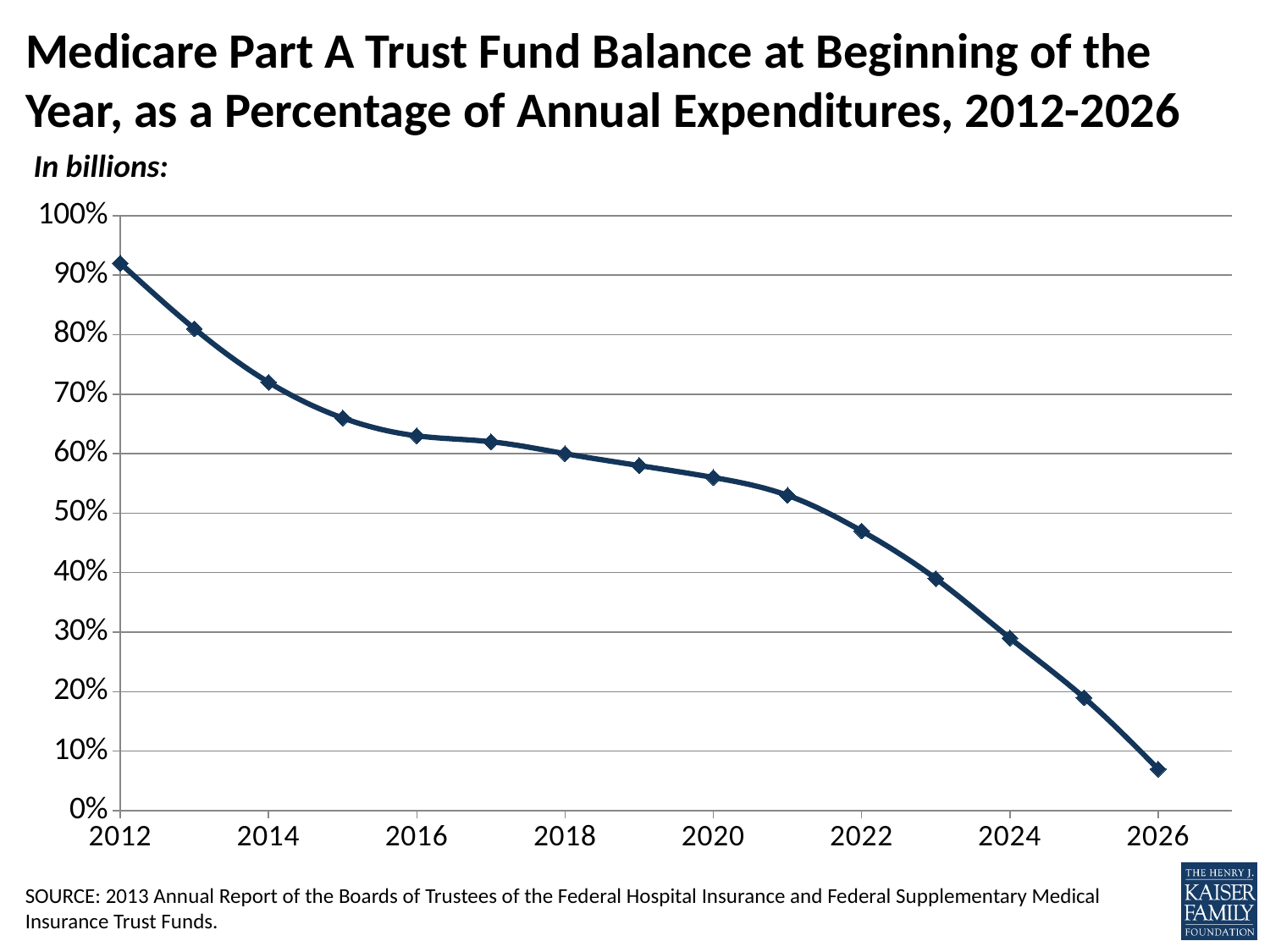
Which is larger, the value for 2016 or the value for 2024? 2016 Is the value for 2026 greater or less than 10%? less What is the source cited for the chart? 2013 Annual Report of the Boards of Trustees of the Federal Hospital Insurance and Federal Supplementary Medical Insurance Trust Funds Which year has the highest trust fund balance as a percentage of annual expenditures? 2012 Is the value for 2014 greater or less than 70%? greater Do the values rise or fall from 2012 to 2026? fall Which year has the lowest trust fund balance as a percentage of annual expenditures? 2026 How many data points are plotted on the line? 15 Is the value for 2012 greater or less than 90%? greater What kind of chart is shown on the slide? line chart